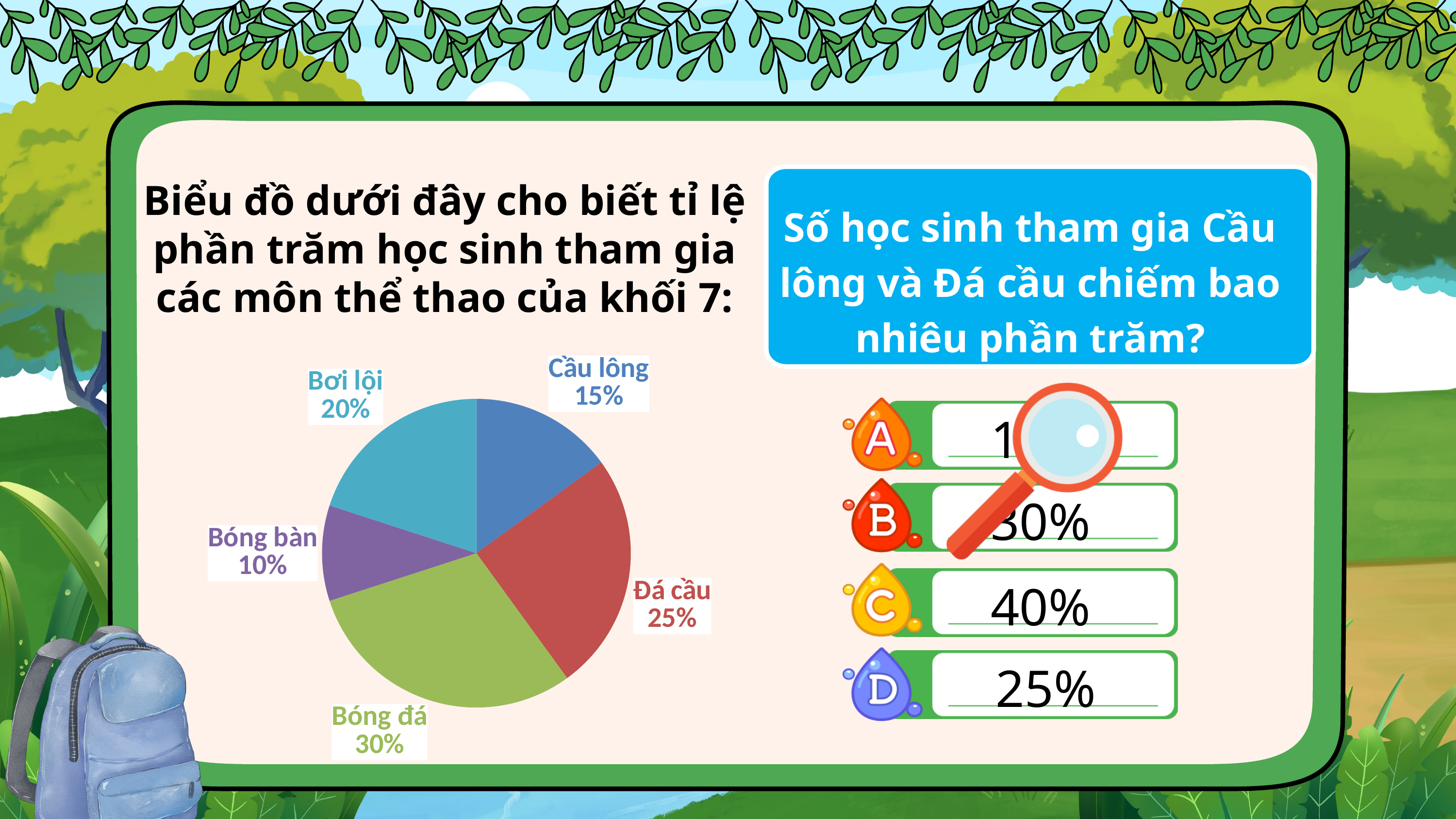
What colour is the Đá cầu slice of the pie chart? Red What percentage of students participate in Bóng đá? 30% Which has a larger share, Đá cầu or Bơi lội? Đá cầu What is the combined percentage of Bơi lội and Bóng bàn? 30% How many sports are shown in the pie chart? 5 Which sport has the largest share of the pie chart? Bóng đá What is the combined percentage of Cầu lông and Đá cầu? 40% What is the difference in percentage between Bóng đá and Bóng bàn? 20% Which sport has the smallest share of the pie chart? Bóng bàn What type of chart is shown on the slide? Pie chart What percentage of students participate in Cầu lông? 15% What percentage of students participate in Bơi lội? 20%